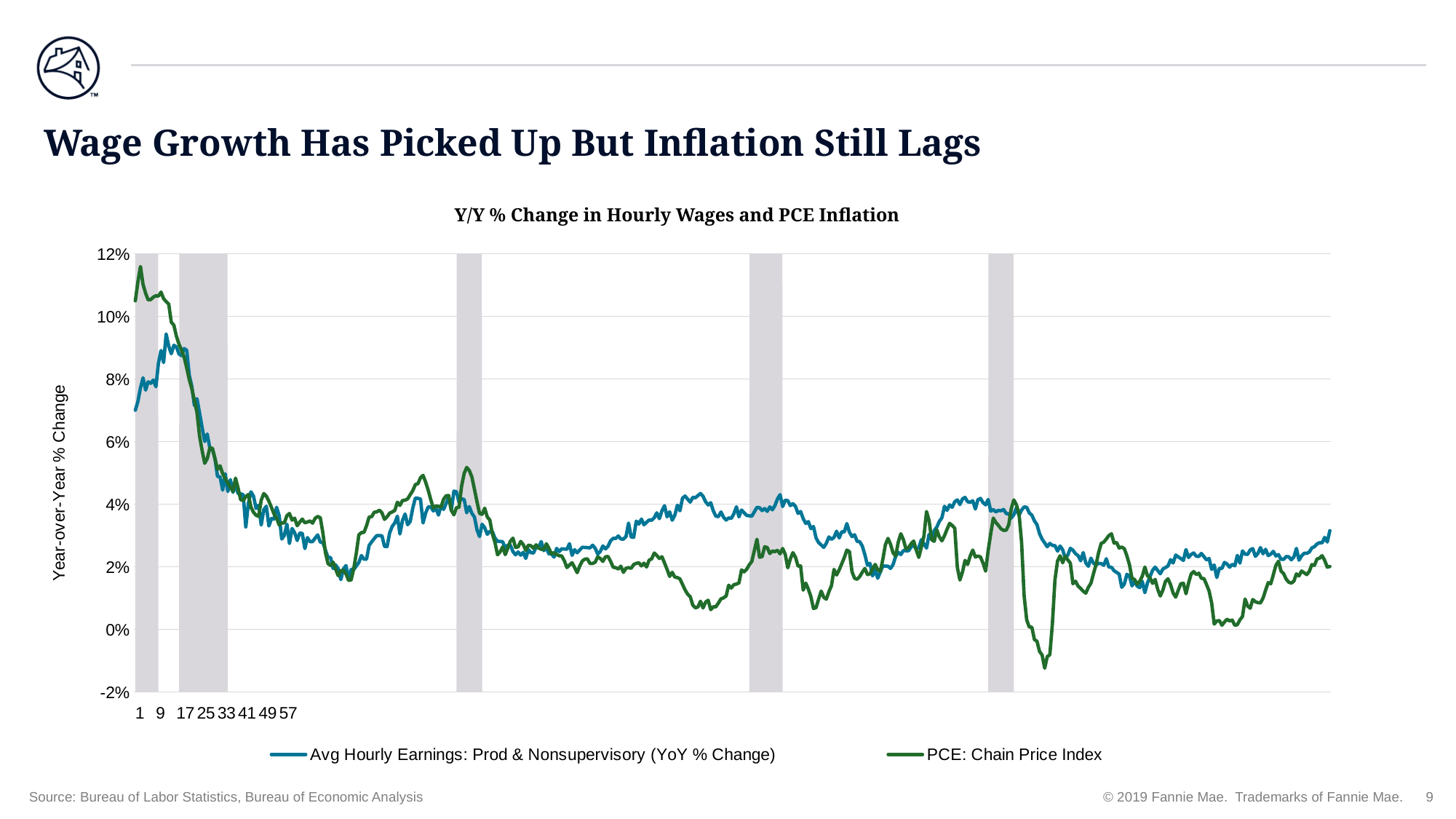
At the start of the series, which is higher: PCE: Chain Price Index or Avg Hourly Earnings: Prod & Nonsupervisory? PCE: Chain Price Index Is the lowest value of the Avg Hourly Earnings: Prod & Nonsupervisory series greater or less than 0%? greater What is the label on the vertical axis of the chart? Year-over-Year % Change From the start of the chart to its end, do the values of the Avg Hourly Earnings series generally rise or fall? fall What kind of chart is shown on the slide? Line chart Which series reaches the highest value anywhere on the chart? PCE: Chain Price Index How many series does the legend list? 2 Is the highest value of the PCE: Chain Price Index series greater or less than 10%? greater Is the final value of the PCE: Chain Price Index series greater or less than 4%? less What is the title of the chart? Y/Y % Change in Hourly Wages and PCE Inflation